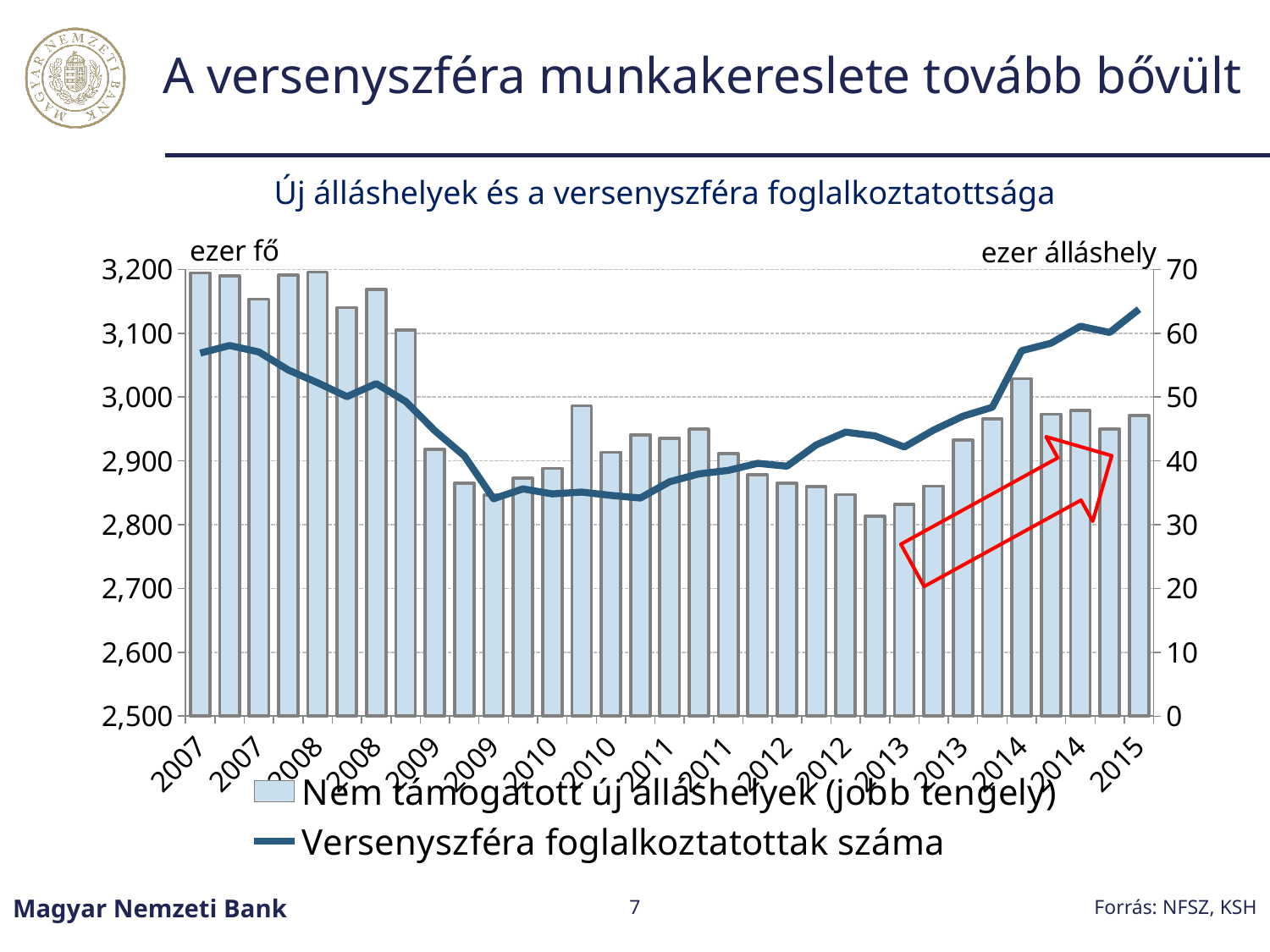
Which series is plotted as bars according to the legend? Nem támogatott új álláshelyek (jobb tengely) Do the bars for Nem támogatott új álláshelyek rise or fall from 2007 to 2009? fall Is the lowest point of the Versenyszféra foglalkoztatottak száma line, in 2009, greater or less than 2,900 on the left axis? less What kind of chart is shown on the slide? A combined bar and line chart In which year does the lowest bar (Nem támogatott új álláshelyek) occur? 2012 How many series does the legend list? 2 Is the value of the leftmost 2007 bar (Nem támogatott új álláshelyek) greater or less than 60 on the right axis? greater Is the Versenyszféra foglalkoztatottak száma line at its 2015 end point greater or less than 3,100 on the left axis? greater What is the title of the chart? Új álláshelyek és a versenyszféra foglalkoztatottsága Does the Versenyszféra foglalkoztatottak száma line rise or fall between 2013 and 2015? rise